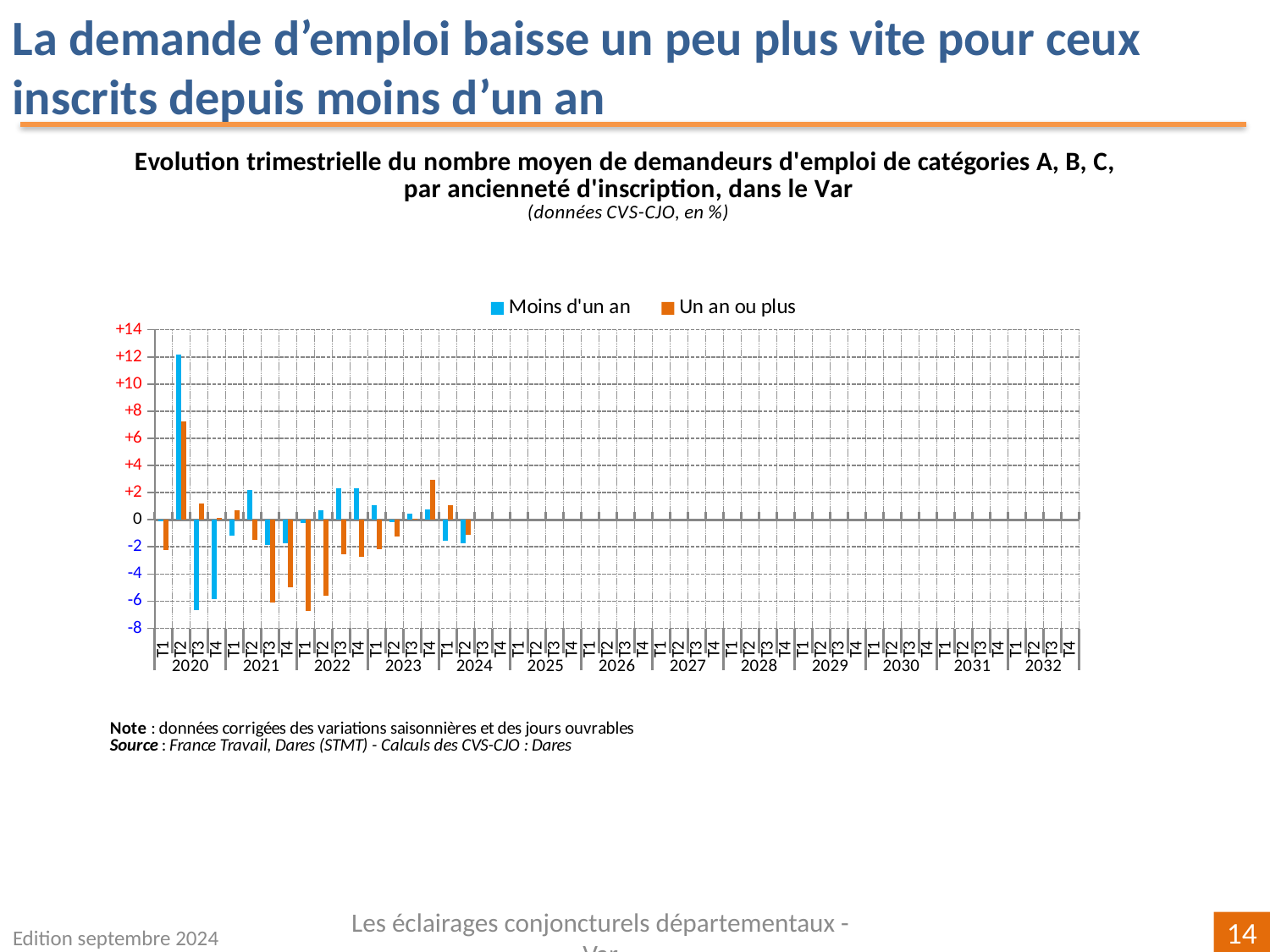
What are the two series named in the legend? Moins d'un an; Un an ou plus How many series does the legend list? 2 In which quarter is the value for 'Un an ou plus' highest? T2 2020 Is the value for 'Moins d'un an' in T3 2020 greater or less than -4? less Is the value for 'Un an ou plus' in T2 2020 greater or less than +8? less In T4 2023, which series has the larger value, 'Moins d'un an' or 'Un an ou plus'? Un an ou plus Is the value for 'Un an ou plus' in T1 2022 greater or less than -6? less How many years are labelled along the x axis? 13 In T2 2020, which series has the larger value, 'Moins d'un an' or 'Un an ou plus'? Moins d'un an In which quarter is the value for 'Moins d'un an' highest? T2 2020 What kind of chart is shown on the slide? Bar chart